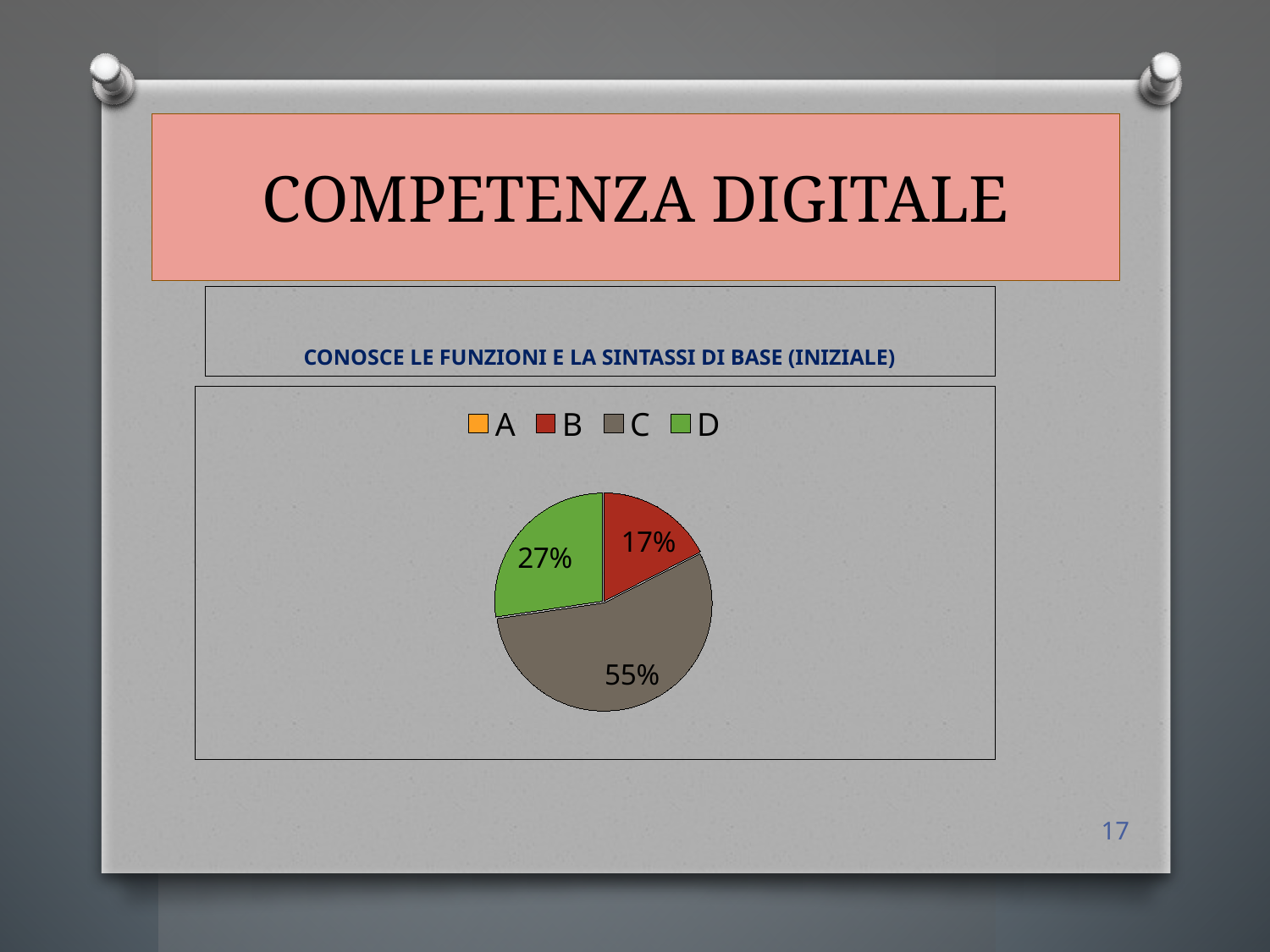
Which is larger in the pie chart, category D or category B? D What type of chart is shown on the slide? pie chart What percentage is shown for category C in the pie chart? 55% What is the difference in percentage points between category C and category B? 38 What is the difference in percentage points between category D and category B? 10 How many slices with percentage labels are visible in the pie chart? 3 What is the title shown above the pie chart? CONOSCE LE FUNZIONI E LA SINTASSI DI BASE (INIZIALE) Of the categories B, C and D, which has the smallest slice of the pie chart? B How many entries does the legend of the pie chart list? 4 What percentage is shown for category B in the pie chart? 17% What percentage is shown for category D in the pie chart? 27% Which category has the largest slice of the pie chart? C